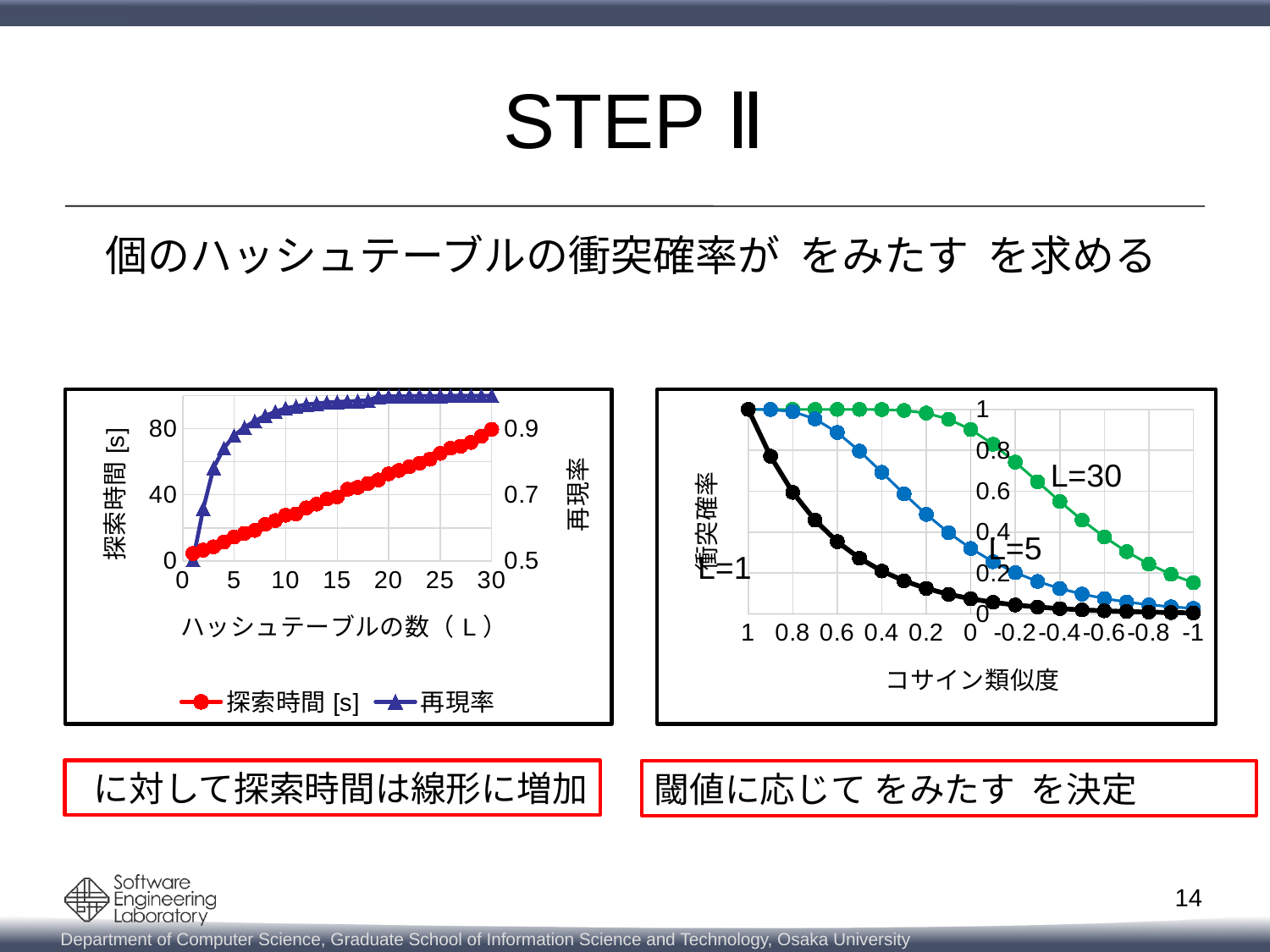
In the right chart, how many lines (series) are plotted? 3 What kind of chart is the left chart on the slide? line chart What kind of chart is the right chart on the slide? line chart In the left chart, how many series does the legend list? 2 In the left chart, does 探索時間 [s] rise or fall as the number of hash tables L increases? rise In the right chart, does 衝突確率 rise or fall as コサイン類似度 goes from 1 to -1 along the x axis? fall In the right chart, at cosine similarity 0.4, which line has the higher 衝突確率, L=30 or L=1? L=30 In the left chart, is the 再現率 value at L=5 greater or less than 0.7? greater What is the x-axis title of the right chart? コサイン類似度 In the left chart, is the 探索時間 [s] value at L=10 greater or less than 40? less In the left chart, does 再現率 rise or fall as L increases? rise In the right chart, is the 衝突確率 for L=30 at cosine similarity 0 greater or less than 0.6? greater